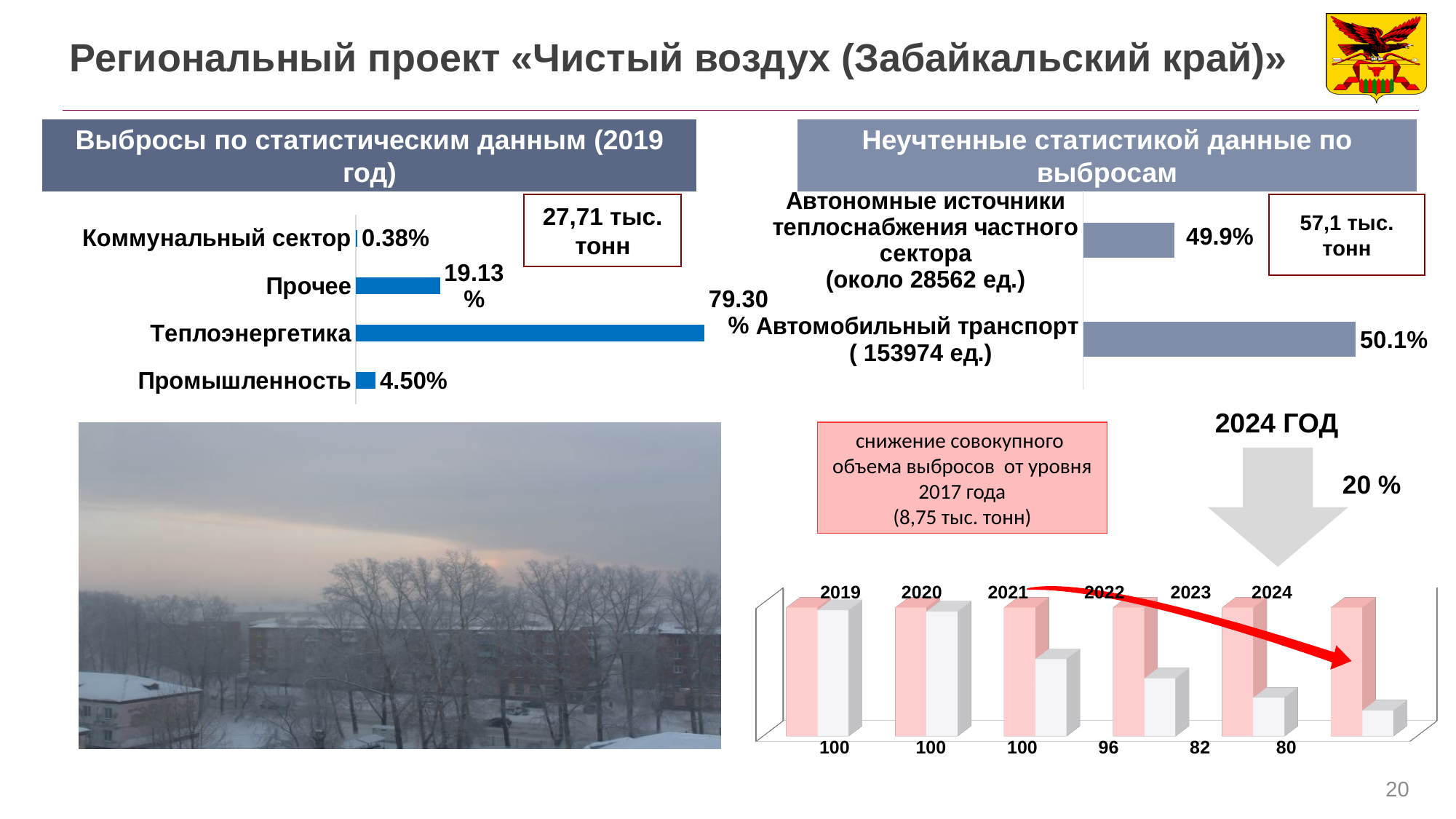
In the bottom-right chart with years 2019–2024, do the labelled values rise or fall from 2021 to 2024? Fall In the chart 'Неучтенные статистикой данные по выбросам', what is the value for Автомобильный транспорт? 50.1% In the chart 'Выбросы по статистическим данным (2019 год)', what is the difference between Прочее and Промышленность? 14.63% In the chart 'Выбросы по статистическим данным (2019 год)', which category has the highest value? Теплоэнергетика In the chart 'Неучтенные статистикой данные по выбросам', what kind of chart is used? Bar chart In the chart 'Выбросы по статистическим данным (2019 год)', how many categories are shown? 4 In the bottom-right chart with years 2019–2024, how many years are shown on the x axis? 6 In the chart 'Выбросы по статистическим данным (2019 год)', which category has the lowest value? Коммунальный сектор In the chart 'Выбросы по статистическим данным (2019 год)', what is the value for Теплоэнергетика? 79.30% In the chart 'Неучтенные статистикой данные по выбросам', what is the value for Автономные источники теплоснабжения частного сектора? 49.9% In the chart 'Выбросы по статистическим данным (2019 год)', what is the value for Прочее? 19.13% In the bottom-right chart with years 2019–2024, what is the value labelled for 2023? 82